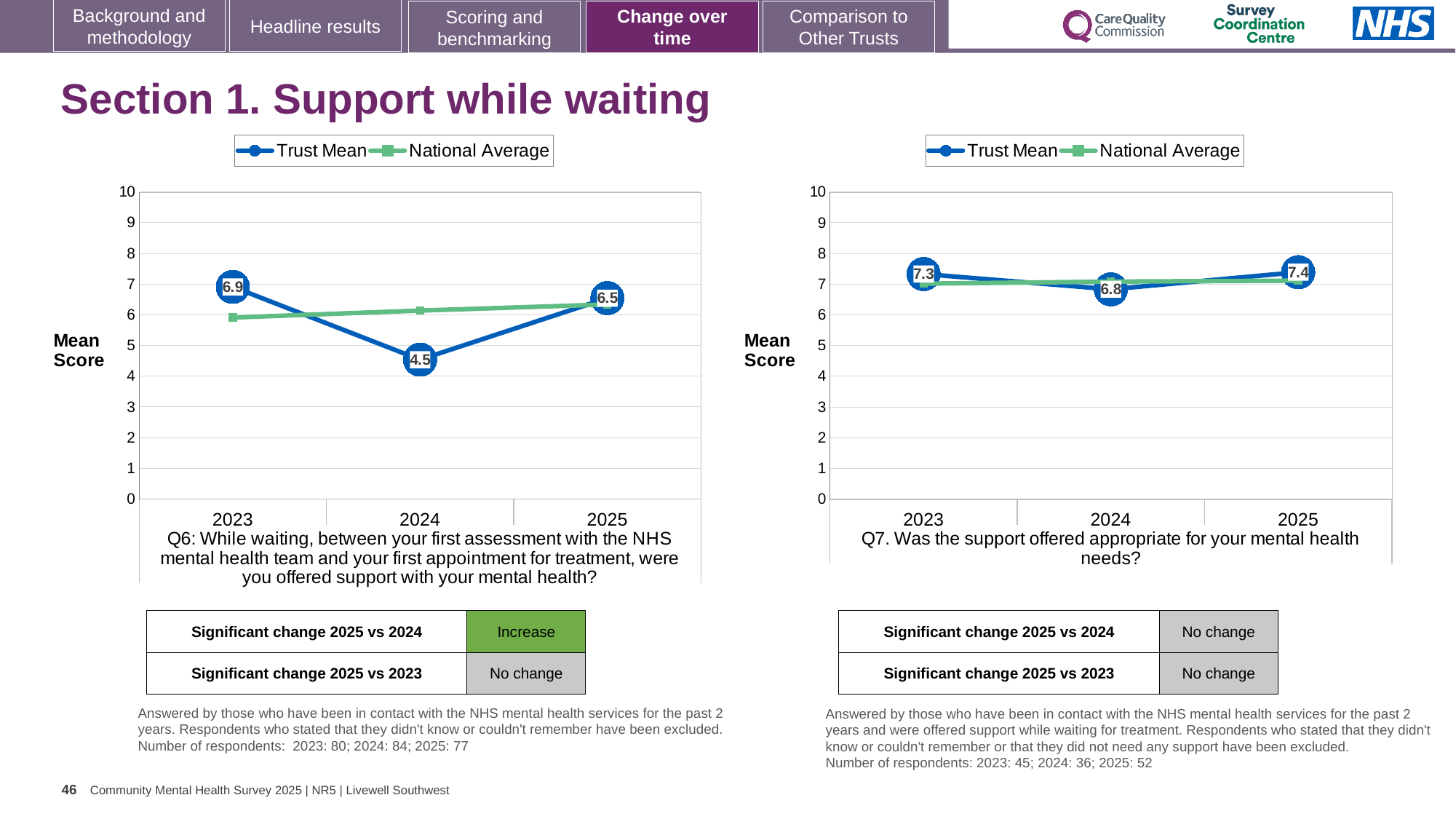
How many series does the legend of the right chart (Q7) list? 2 In the left chart (Q6), does the National Average rise or fall from 2023 to 2025? Rise In the left chart (Q6), what is the difference between the Trust Mean in 2023 and in 2024? 2.4 In the left chart (Q6), which year has the lowest Trust Mean? 2024 In the left chart (Q6), what is the Trust Mean for 2024? 4.5 What type of chart is used for Q6 on the left? Line chart In the left chart (Q6), what is the Trust Mean for 2023? 6.9 In the left chart (Q6), is the Trust Mean for 2025 greater or less than the Trust Mean for 2024? greater In the right chart (Q7), which year has the highest Trust Mean? 2025 In the right chart (Q7), what is the difference between the Trust Mean in 2025 and in 2024? 0.6 In the right chart (Q7), what is the Trust Mean for 2025? 7.4 In the left chart (Q6), is the National Average for 2023 greater or less than 7? less